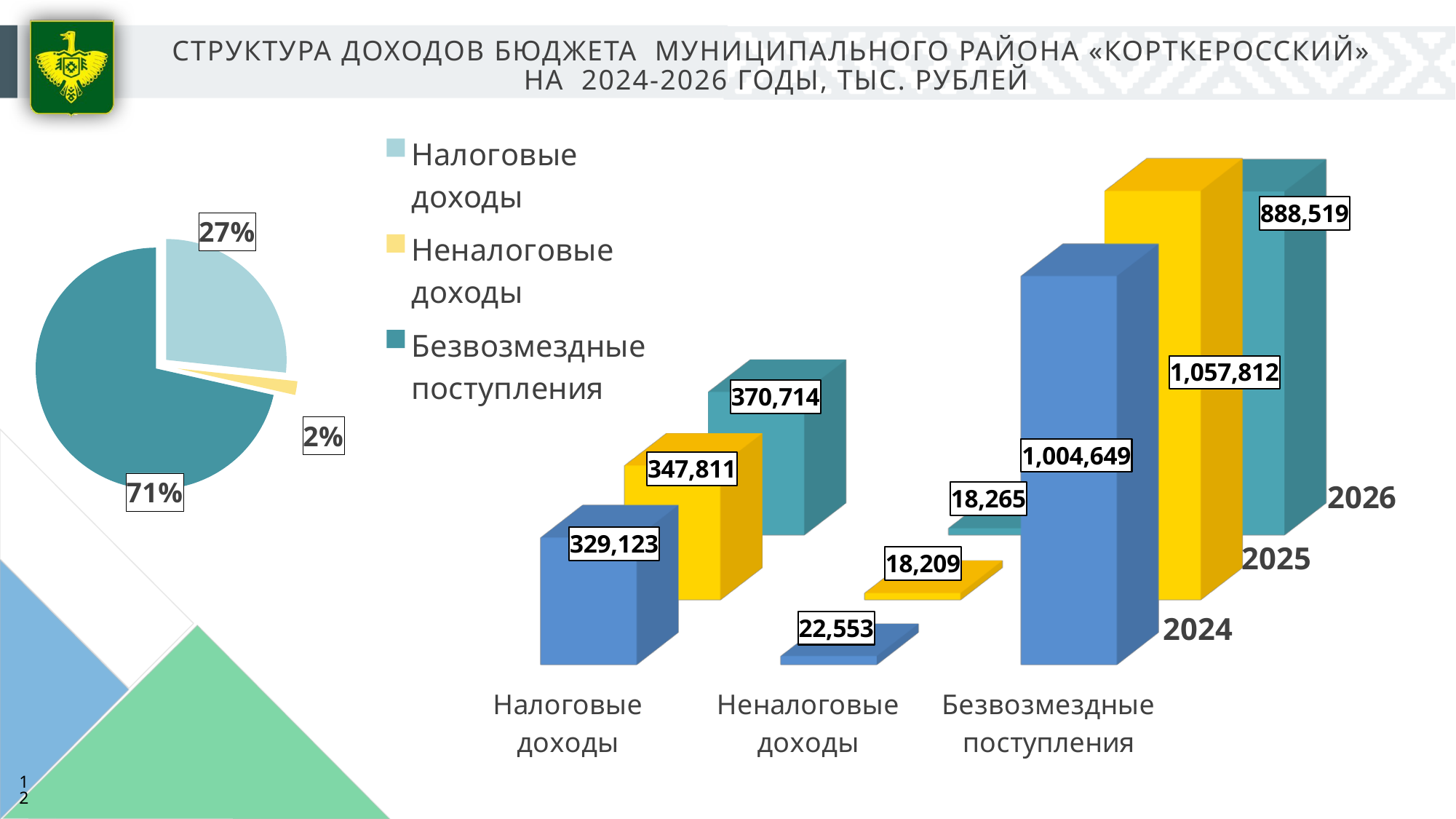
What type of chart is shown on the right side of the slide? bar chart In the bar chart on the right, which is larger: Неналоговые доходы in 2024 or in 2025? 2024 In the bar chart on the right, which year has the lowest value for Безвозмездные поступления? 2026 In the pie chart on the left, what share is shown for Неналоговые доходы? 2% In the pie chart on the left, which category has the largest slice? Безвозмездные поступления In the bar chart on the right, what is the difference between the 2026 and 2024 values for Налоговые доходы? 41,591 In the bar chart on the right, what is the value for Неналоговые доходы in 2026? 18,265 In the bar chart on the right, what is the value for Налоговые доходы in 2024? 329,123 In the bar chart on the right, what is the value for Безвозмездные поступления in 2025? 1,057,812 In the pie chart on the left, how many slices are there? 3 In the pie chart on the left, what share is shown for Безвозмездные поступления? 71% In the bar chart on the right, do the values for Налоговые доходы rise or fall from 2024 to 2026? rise